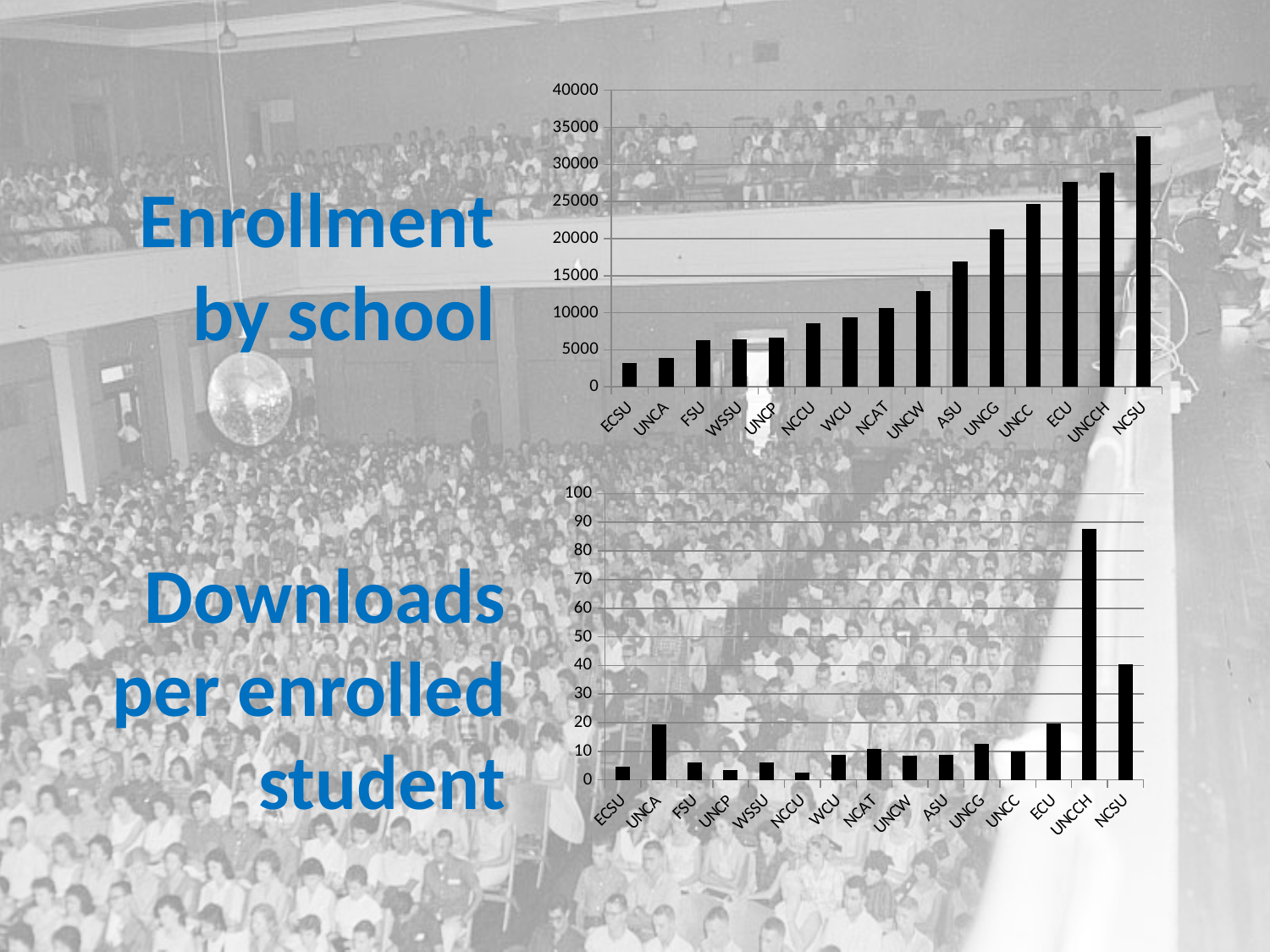
In the Downloads per enrolled student chart, is the value for UNCA greater or less than 10? greater What type of chart is the Enrollment by school chart? bar chart In the Downloads per enrolled student chart, which is larger, the value for UNCCH or the value for NCSU? UNCCH In the Downloads per enrolled student chart, is the value for UNCCH greater or less than 80? greater In the Enrollment by school chart, is the value for NCSU greater or less than 30000? greater How many schools are shown in the Enrollment by school chart? 15 In the Downloads per enrolled student chart, which school has the highest value? UNCCH In the Enrollment by school chart, which school has the lowest enrollment? ECSU In the Enrollment by school chart, do the values rise or fall from left to right? rise In the Enrollment by school chart, which school has the highest enrollment? NCSU In the Enrollment by school chart, which is larger, the value for ECU or the value for UNCW? ECU